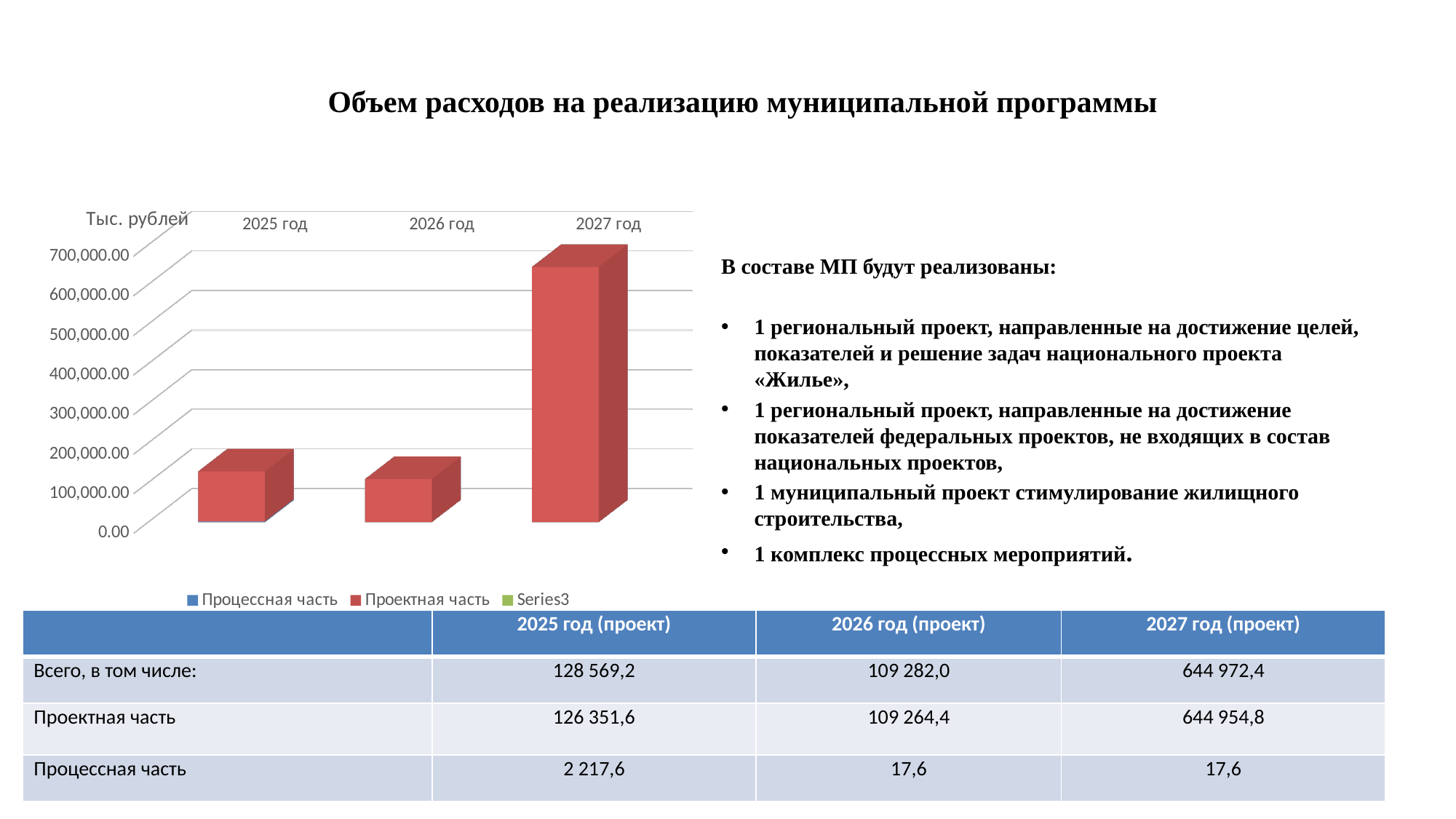
Do the bar values rise steadily from 2025 год to 2027 год? No, they fall from 2025 to 2026 and then rise sharply in 2027 Which bar is taller, 2025 год or 2026 год? 2025 год How many year categories are shown on the x axis of the chart? 3 Is the value for 2025 год greater or less than 200,000.00? less Which year has the lowest bar in the chart? 2026 год Which legend entry is shown in red? Проектная часть Which year has the highest bar in the chart? 2027 год Is the value for 2027 год greater or less than 600,000.00? greater What unit label is shown at the top of the chart's vertical axis? Тыс. рублей How many series does the chart legend list? 3 What kind of chart is shown on the slide? Bar chart Is the value for 2026 год greater or less than 200,000.00? less